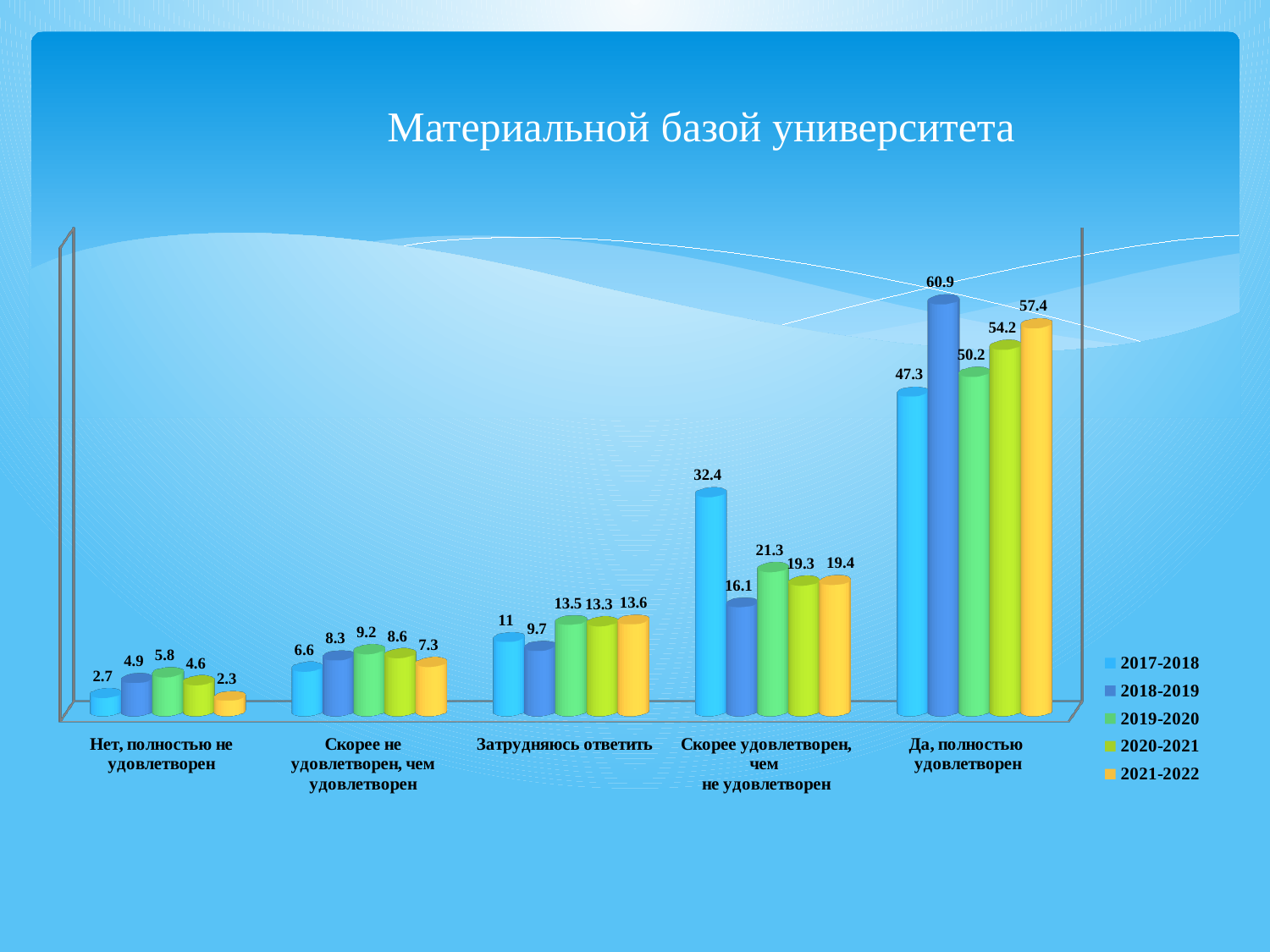
What is the value for 2021-2022 in the "Нет, полностью не удовлетворен" category? 2.3 What is the value for 2019-2020 in the "Затрудняюсь ответить" category? 13.5 What is the difference between the 2021-2022 and 2017-2018 values in the "Да, полностью удовлетворен" category? 10.1 How many series does the legend list? 5 What kind of chart is shown on the slide? Bar chart Which is larger in the "Скорее удовлетворен, чем не удовлетворен" category: the 2019-2020 value or the 2018-2019 value? 2019-2020 What is the value for 2017-2018 in the "Скорее удовлетворен, чем не удовлетворен" category? 32.4 How many categories are shown on the x axis? 5 What is the value for 2018-2019 in the "Да, полностью удовлетворен" category? 60.9 Which series has the highest value in the "Да, полностью удовлетворен" category? 2018-2019 Which series has the lowest value in the "Скорее не удовлетворен, чем удовлетворен" category? 2017-2018 What is the title of the chart? Материальной базой университета